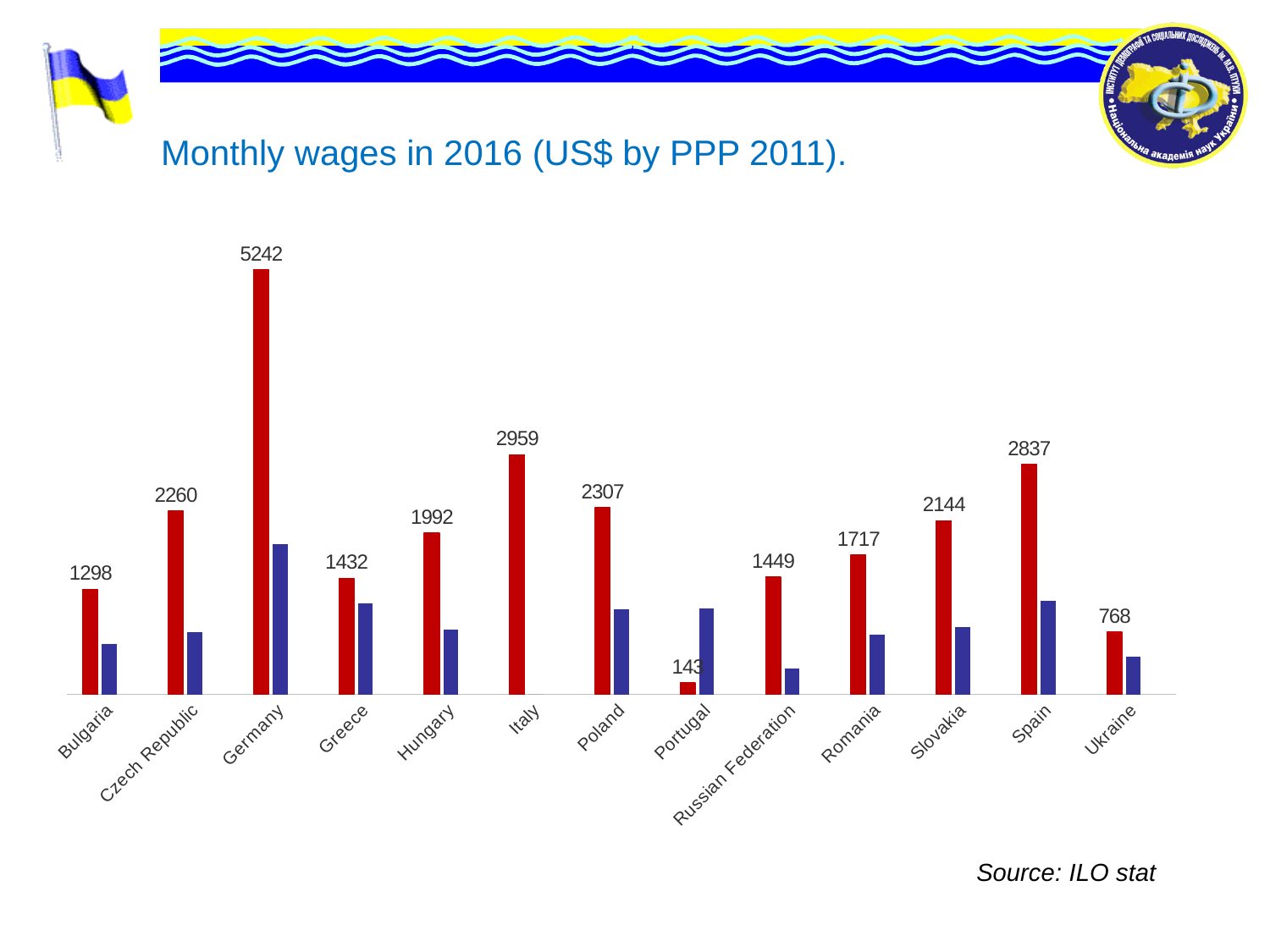
How many countries are shown on the x axis of the chart? 13 What is the difference between the labelled values for Germany and Italy? 2283 What is the labelled value of the red bar for Ukraine? 768 What is the title of the chart? Monthly wages in 2016 (US$ by PPP 2011). What is the labelled value of the red bar for Hungary? 1992 What is the labelled value of the red bar for Germany? 5242 Which country has the highest labelled red bar? Germany What is the labelled value of the red bar for Slovakia? 2144 What is the difference between the labelled values for Spain and Ukraine? 2069 What kind of chart is shown on the slide? bar chart Which has the larger labelled value, Poland or Czech Republic? Poland Which country has the lowest red bar? Portugal